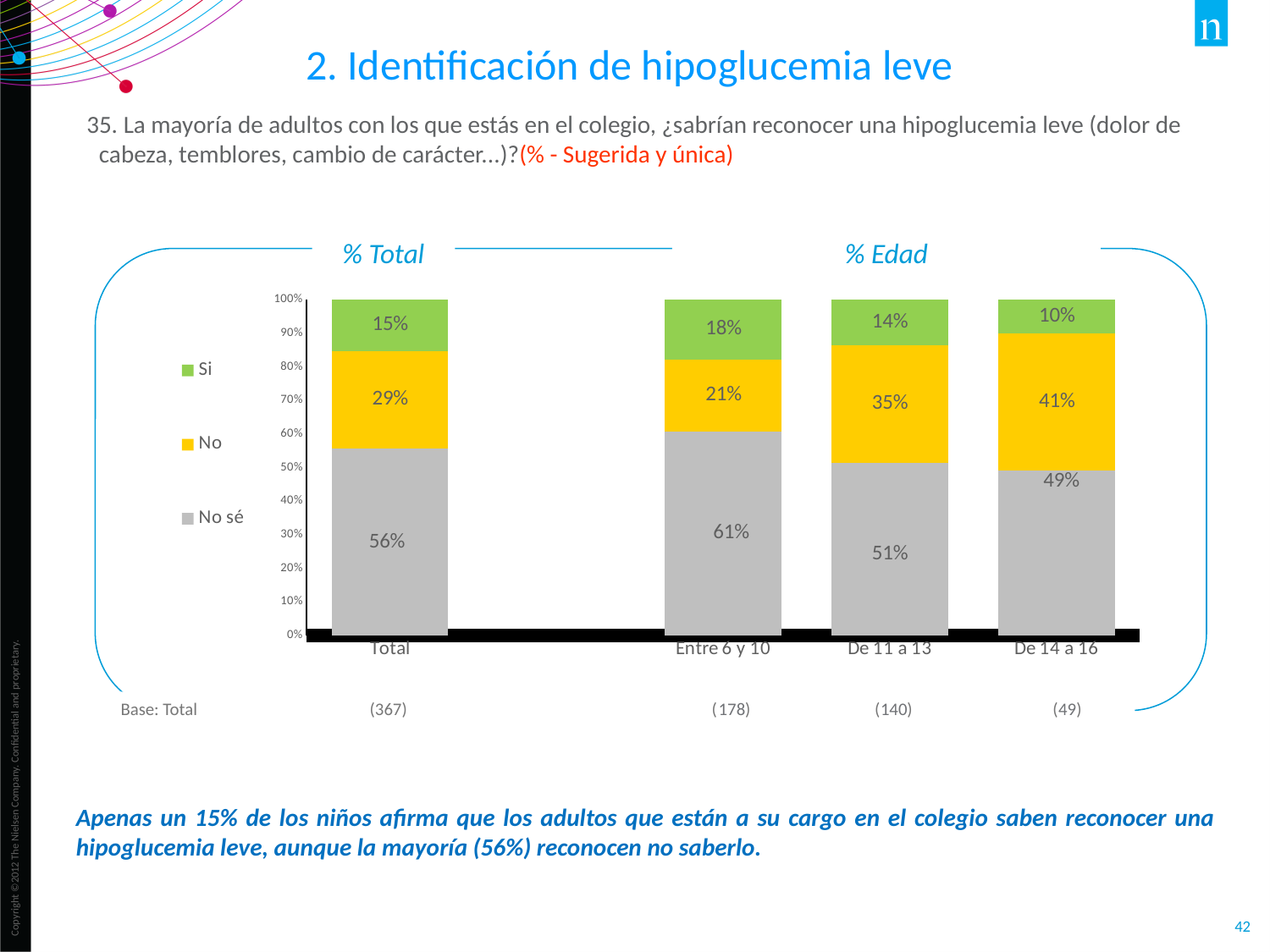
Which colour represents the 'No' series in the legend? Yellow Which is larger, the 'No sé' value for 'Entre 6 y 10' or for 'De 11 a 13'? Entre 6 y 10 What percentage of the 'Total' bar is 'No sé'? 56% Does the 'Si' value rise or fall across the age groups from 'Entre 6 y 10' to 'De 14 a 16'? Fall How many series does the legend list? 3 Which category has the highest 'Si' value? Entre 6 y 10 What is the 'Si' value for the 'De 14 a 16' category? 10% How many categories are shown on the x axis? 4 What is the difference between the 'No' values for 'De 14 a 16' and 'Entre 6 y 10'? 20% Which category has the lowest 'No sé' value? De 14 a 16 What is the 'No' value for the 'De 11 a 13' category? 35% What kind of chart is shown on the slide? Stacked bar chart